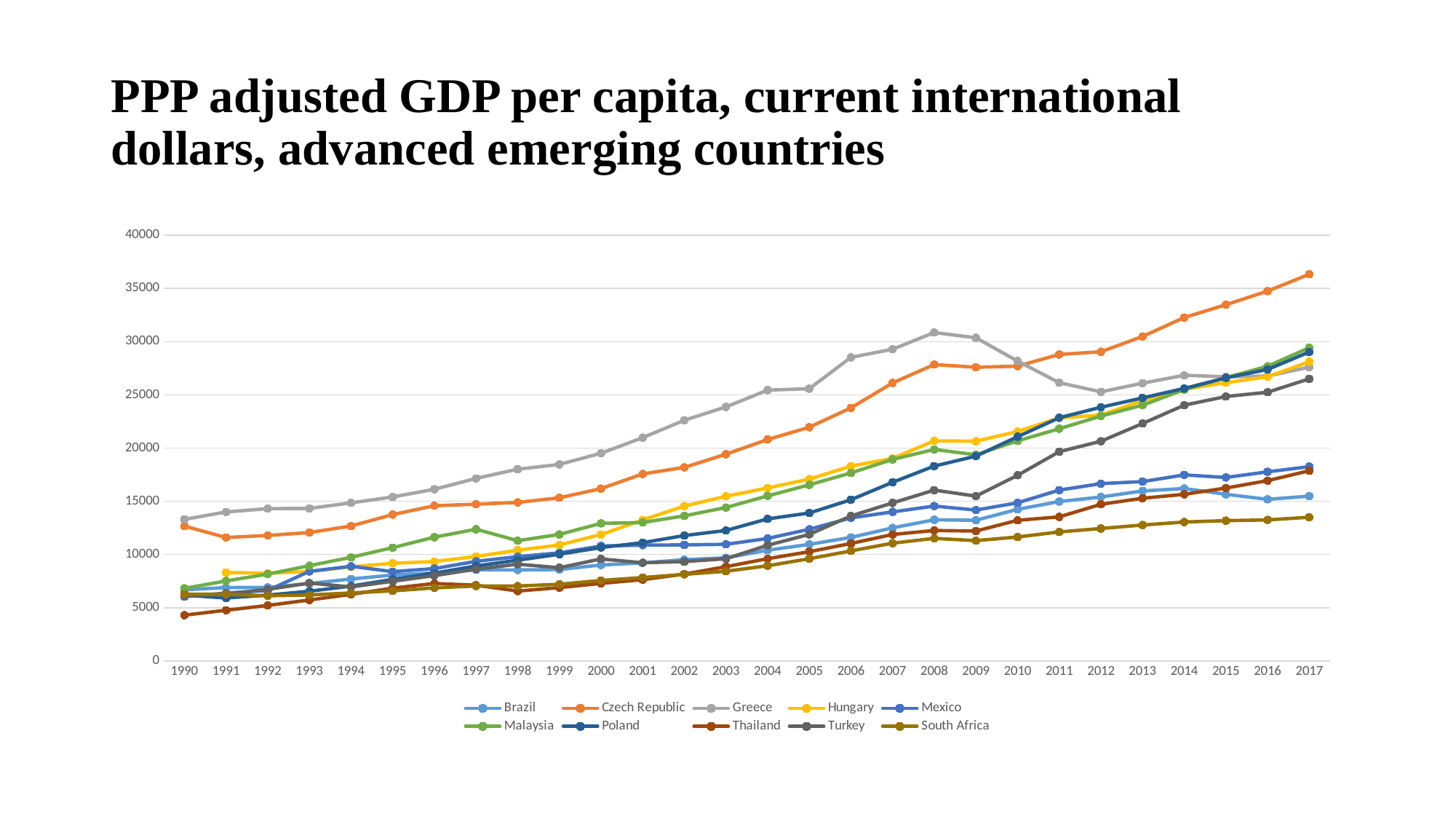
What kind of chart is shown on the slide? line chart Which country has the lowest value in 2017? South Africa How many series does the legend list? 10 How many years are plotted along the x axis? 28 Which is larger in 2017, the value for Turkey or the value for Mexico? Turkey Does the value for Greece rise or fall between 2008 and 2012? fall Is the value for Poland in 2017 greater or less than 25000? greater Which is larger in 2000, the value for Greece or the value for Czech Republic? Greece Which country has the lowest value in 1990? Thailand Is the value for South Africa in 2017 greater or less than 15000? less Is the value for Czech Republic in 2017 greater or less than 35000? greater Which country has the highest value in 2017? Czech Republic